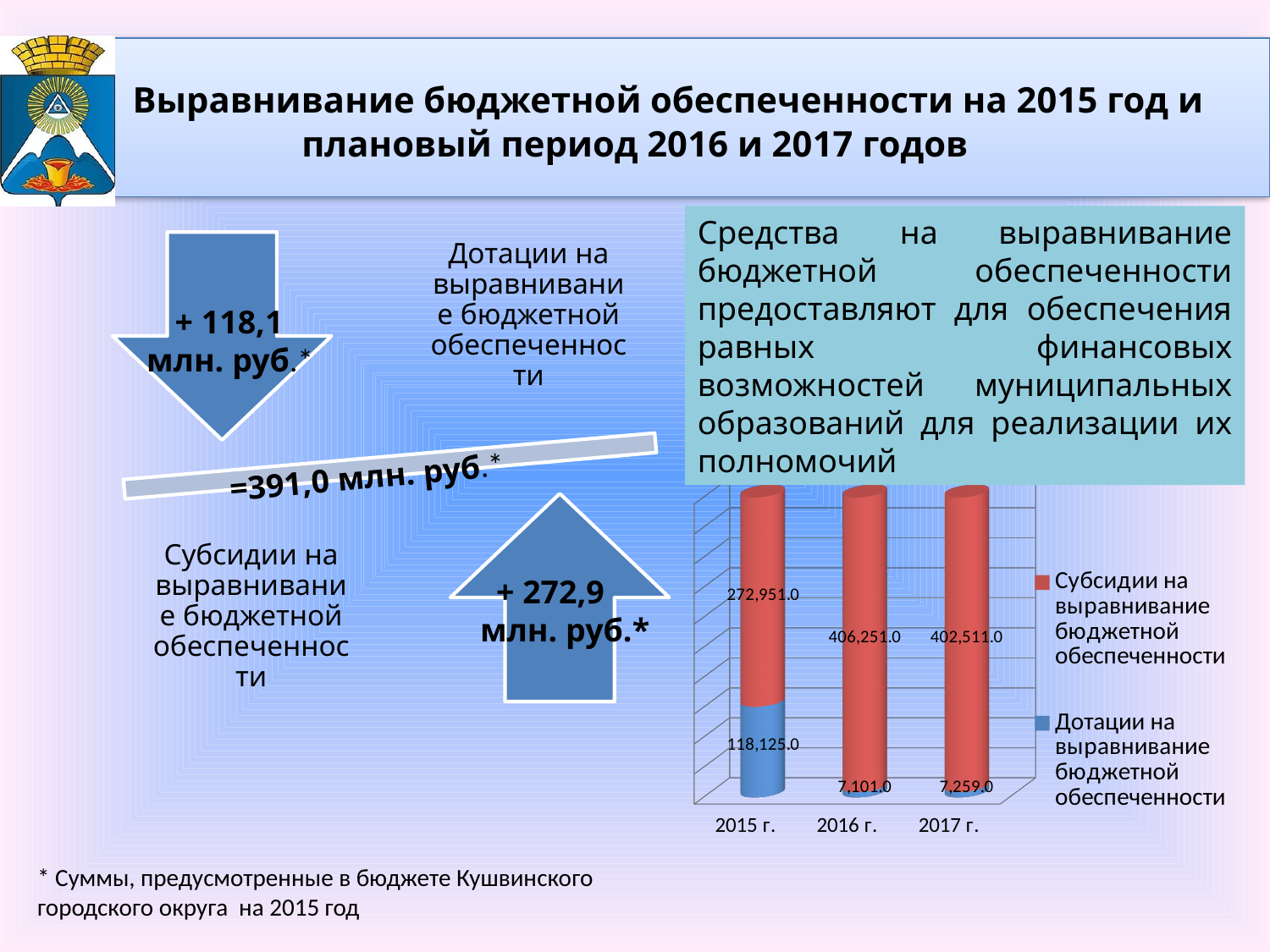
What is the difference between the Дотации values for 2015 г. and 2016 г.? 111,024.0 What is the value of Субсидии на выравнивание бюджетной обеспеченности for 2017 г.? 402,511.0 How many years are shown on the x axis of the chart? 3 What is the value of Субсидии на выравнивание бюджетной обеспеченности for 2015 г.? 272,951.0 How many series does the chart legend list? 2 What is the value of Дотации на выравнивание бюджетной обеспеченности for 2016 г.? 7,101.0 In which year is the value of Субсидии на выравнивание бюджетной обеспеченности the highest? 2016 г. What is the difference between the Субсидии values for 2016 г. and 2017 г.? 3,740.0 What is the value of Дотации на выравнивание бюджетной обеспеченности for 2015 г.? 118,125.0 In which year is the value of Дотации на выравнивание бюджетной обеспеченности the lowest? 2016 г. What is the total of the stacked bar for 2015 г.? 391,076.0 Which is larger: the Дотации value for 2017 г. or for 2016 г.? 2017 г.